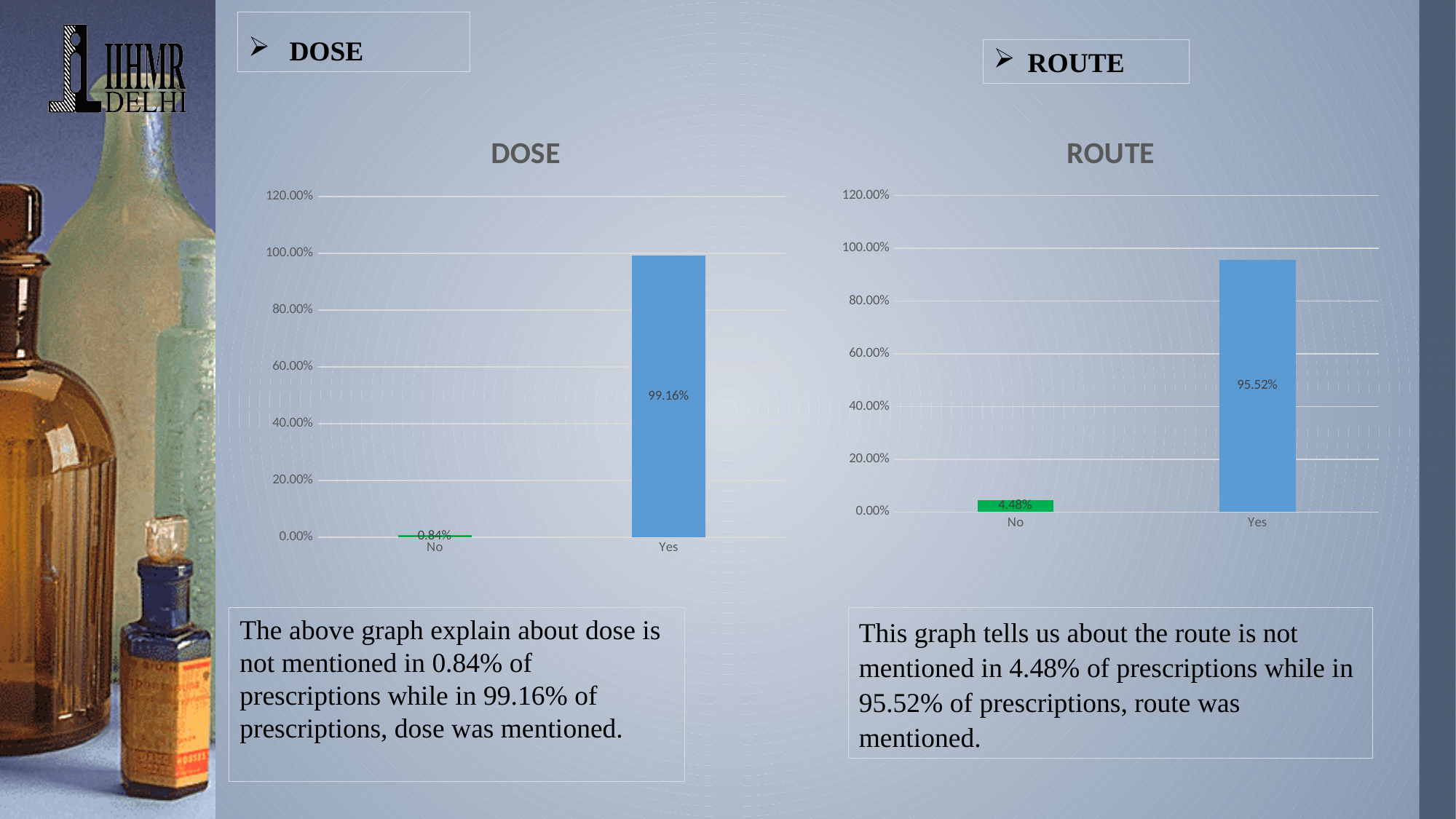
How many categories are shown in the DOSE chart? 2 Is the No value in the ROUTE chart larger or smaller than the No value in the DOSE chart? larger In the DOSE chart, what is the value for Yes? 99.16% In the ROUTE chart, which category has the lowest value? No In the DOSE chart, which category has the highest value? Yes In the ROUTE chart, what is the value for No? 4.48% In the ROUTE chart, what is the value for Yes? 95.52% In the DOSE chart, what is the difference between the Yes and No values? 98.32% In the ROUTE chart, is the value for Yes greater or less than 80.00%? greater In the DOSE chart, what is the value for No? 0.84% In the ROUTE chart, what is the difference between the Yes and No values? 91.04% What type of chart is the ROUTE chart? bar chart